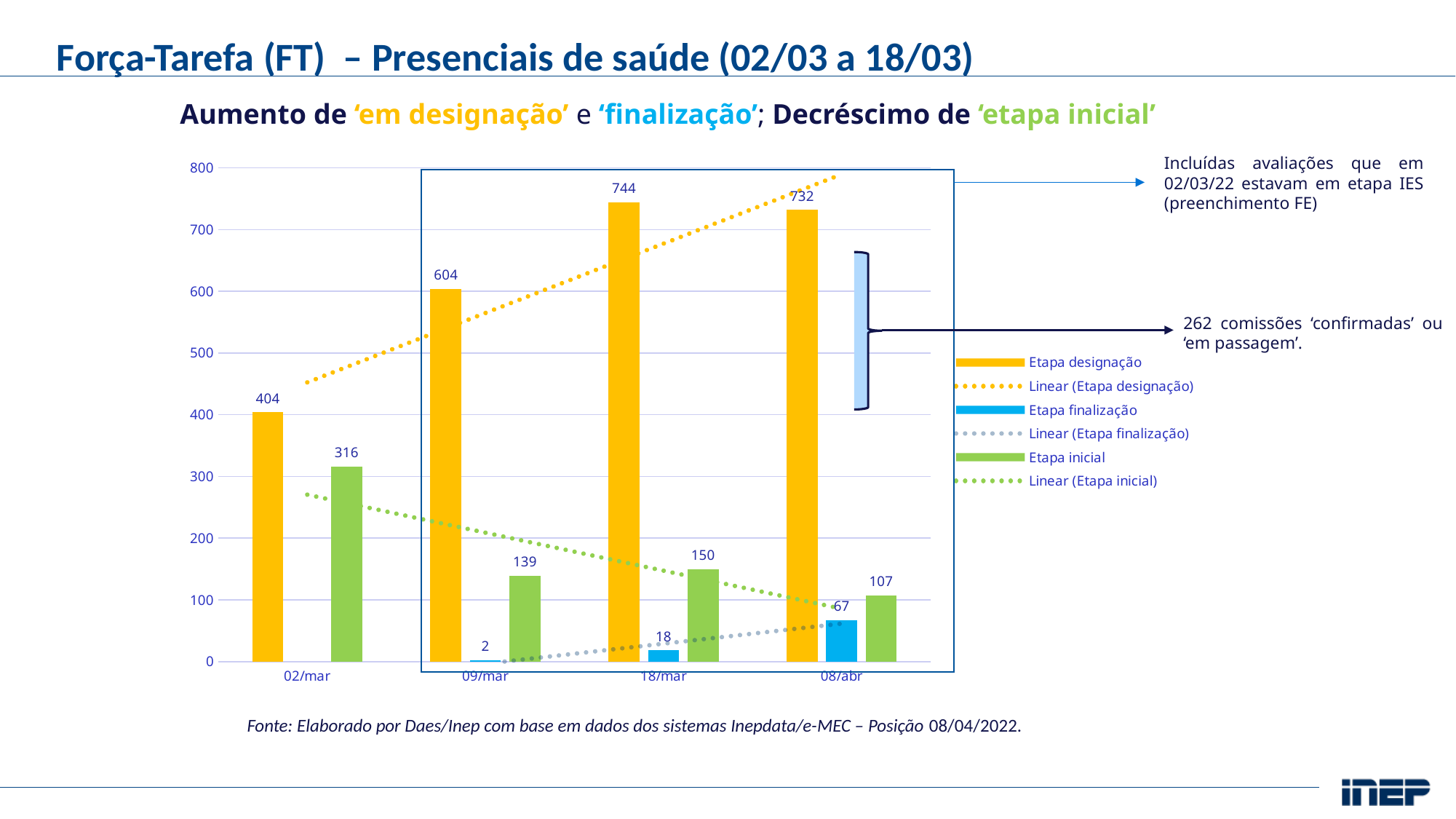
What colour are the Etapa inicial bars? Green How many dates are shown on the x axis? 4 Does Etapa finalização rise or fall from 09/mar to 08/abr? Rise What is the difference between Etapa designação on 09/mar and on 02/mar? 200 Which is larger on 18/mar: Etapa inicial or Etapa finalização? Etapa inicial On which date is Etapa designação highest? 18/mar What kind of chart is shown on the slide? Bar chart How many entries does the legend list? 6 On which date is Etapa inicial lowest? 08/abr What is the value of Etapa designação on 18/mar? 744 What is the value of Etapa finalização on 08/abr? 67 What is the value of Etapa inicial on 02/mar? 316